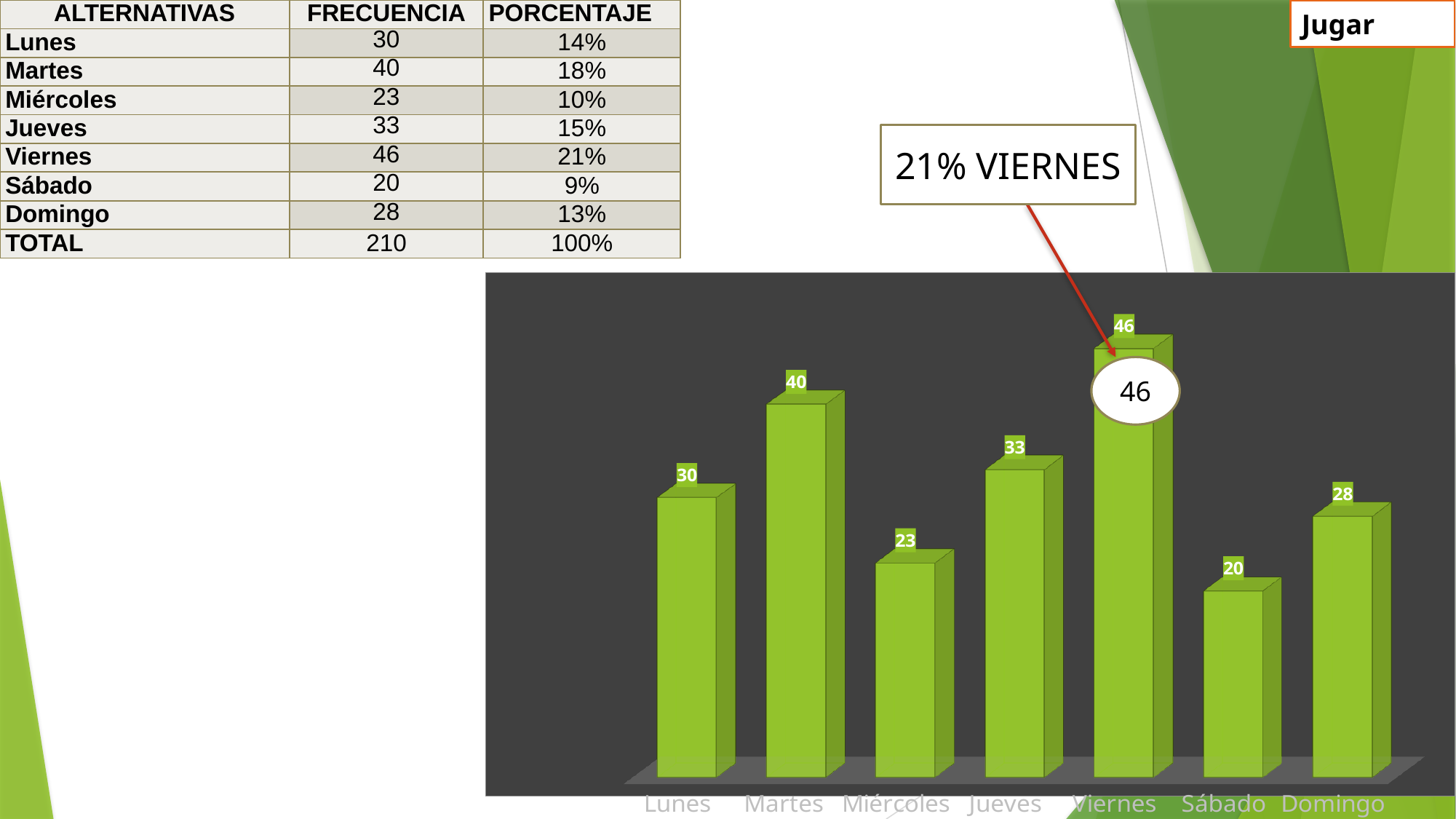
How many days are shown on the x axis of the chart? 7 What kind of chart is shown on the slide? bar chart What is the difference between the values for Viernes and Sábado? 26 Which is larger, the value for Jueves or the value for Domingo? Jueves Which is larger, the value for Lunes or the value for Miércoles? Lunes Which day has the lowest bar? Sábado What is the value of the bar for Viernes? 46 Which day has the highest bar? Viernes What is the value of the bar for Domingo? 28 What percentage does the callout on the chart attribute to Viernes? 21% What is the difference between the values for Martes and Lunes? 10 What is the value of the bar for Miércoles? 23